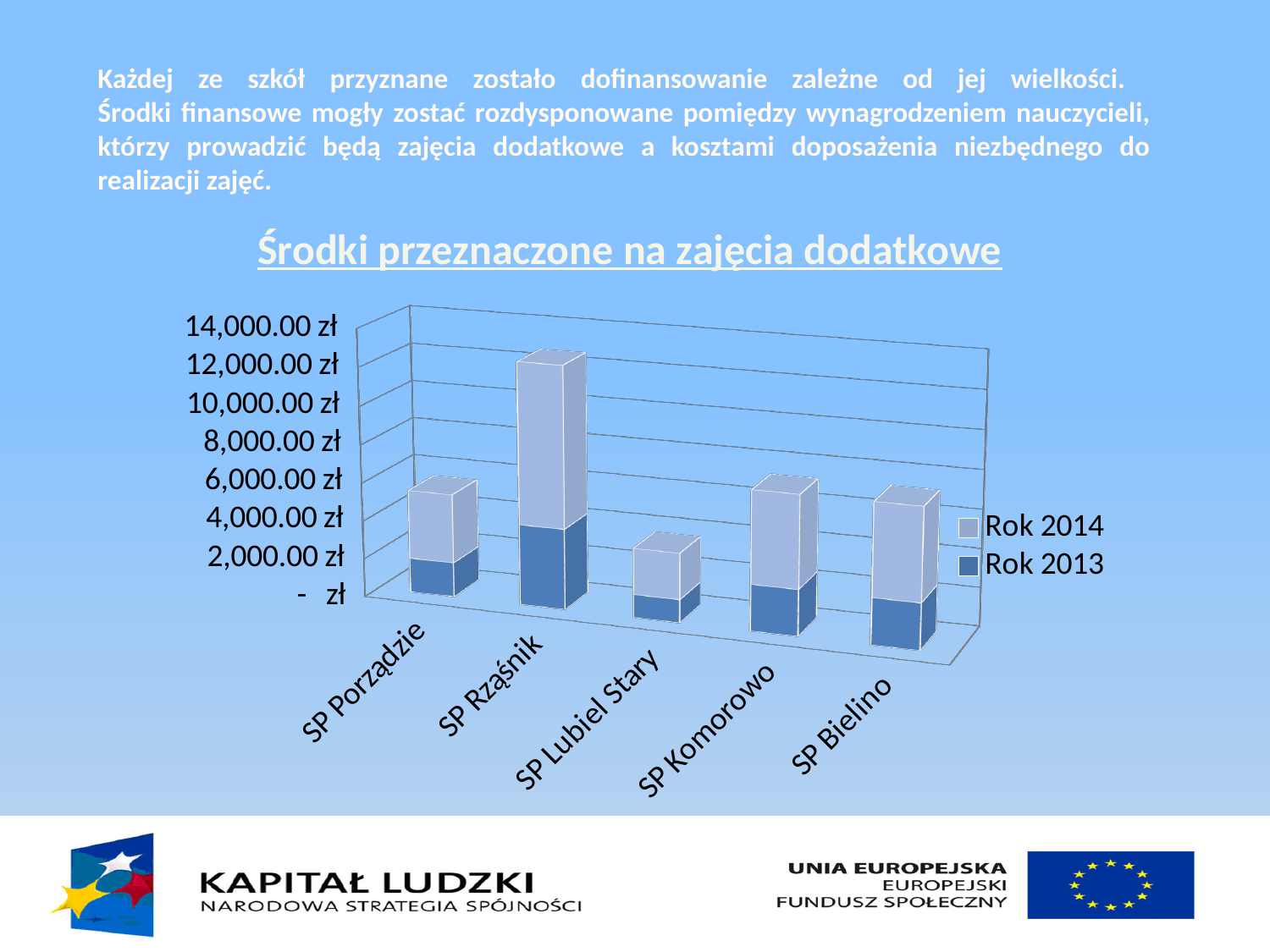
Which school has the lowest total bar on the chart? SP Lubiel Stary Is the total value for SP Rząśnik greater or less than 8,000.00 zł? greater Which school has the highest total bar on the chart? SP Rząśnik How many series does the chart legend list? 2 Is the total value for SP Porządzie greater or less than 2,000.00 zł? greater How many schools (categories) are shown on the chart? 5 Is the total value for SP Lubiel Stary greater or less than 4,000.00 zł? less What is the title of the chart? Środki przeznaczone na zajęcia dodatkowe Which has the larger total bar, SP Lubiel Stary or SP Bielino? SP Bielino What kind of chart is shown on the slide? Stacked bar chart Which has the larger total bar, SP Rząśnik or SP Komorowo? SP Rząśnik What are the two series listed in the chart legend? Rok 2014 and Rok 2013